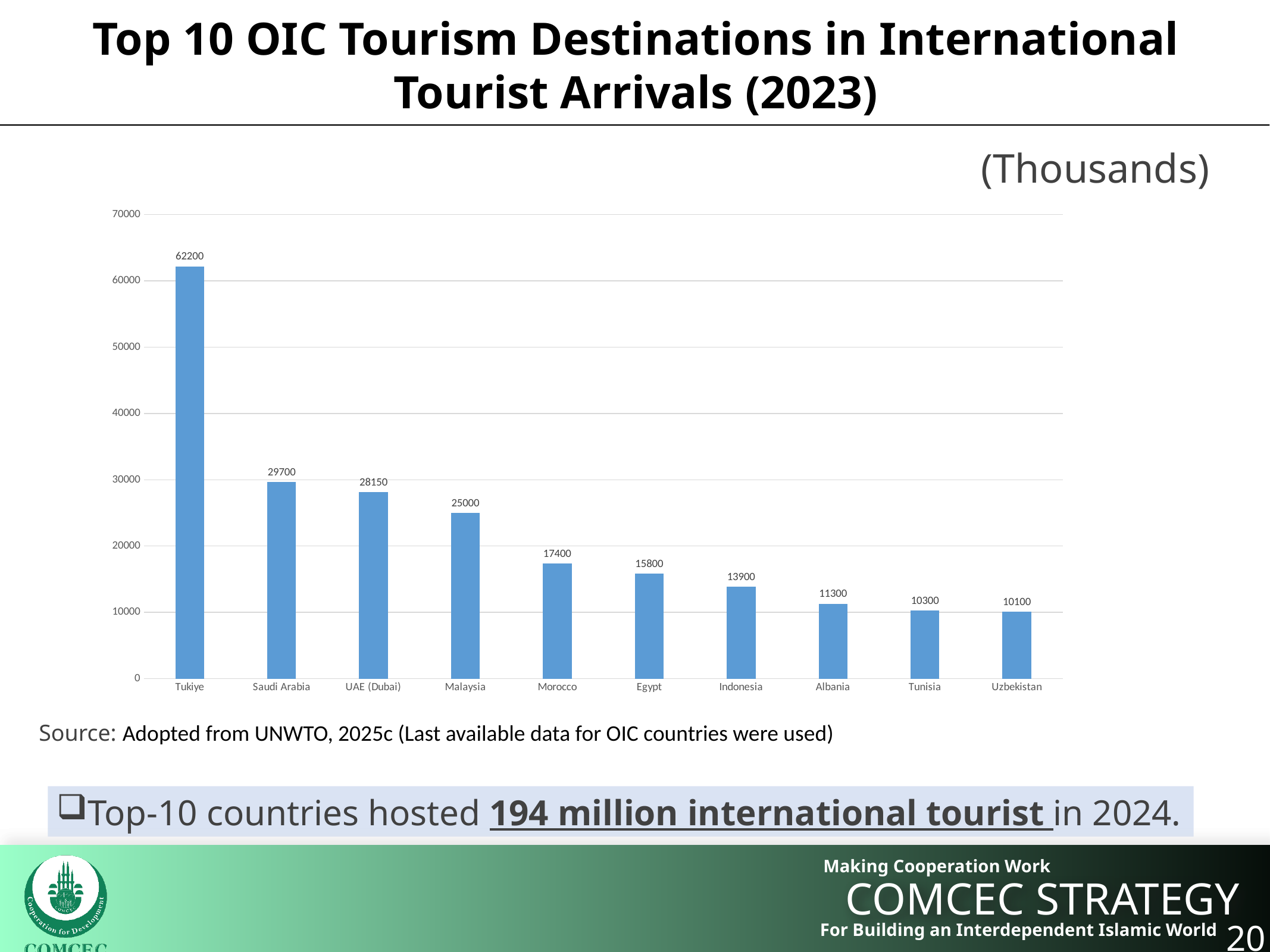
Which country has the lowest value? Uzbekistan What is the difference between the values for Tukiye and Saudi Arabia? 32500 Which country has the highest value? Tukiye What is the value for Uzbekistan? 10100 How many countries are shown in the chart? 10 What kind of chart is shown on the slide? bar chart What is the value for Saudi Arabia? 29700 What is the value for Morocco? 17400 Is the value for Albania greater or less than 10000? greater Which is larger, the value for Malaysia or the value for UAE (Dubai)? UAE (Dubai) Do the values rise or fall from left to right along the x axis? fall What is the difference between the values for Egypt and Indonesia? 1900